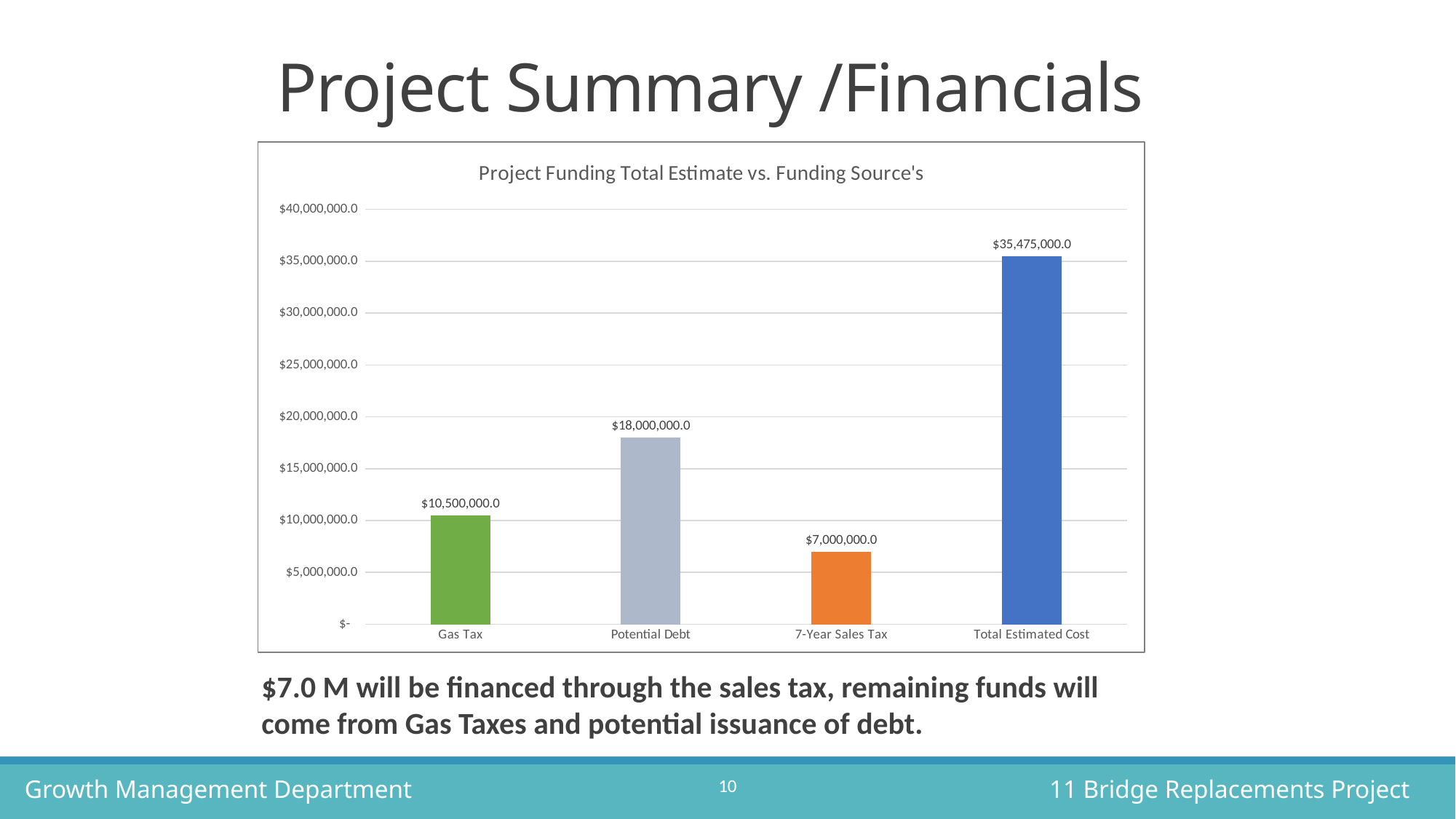
What is the value for Potential Debt? $18,000,000.0 Which category has the lowest value? 7-Year Sales Tax Is the value for Potential Debt greater or less than $15,000,000.0? greater Which is larger, Gas Tax or 7-Year Sales Tax? Gas Tax What is the title of the chart? Project Funding Total Estimate vs. Funding Source's Which category has the highest value? Total Estimated Cost What kind of chart is shown? Bar chart What is the value for Total Estimated Cost? $35,475,000.0 What is the difference between Potential Debt and Gas Tax? $7,500,000.0 What is the value for 7-Year Sales Tax? $7,000,000.0 What is the value for Gas Tax? $10,500,000.0 How many categories are shown on the x axis? 4